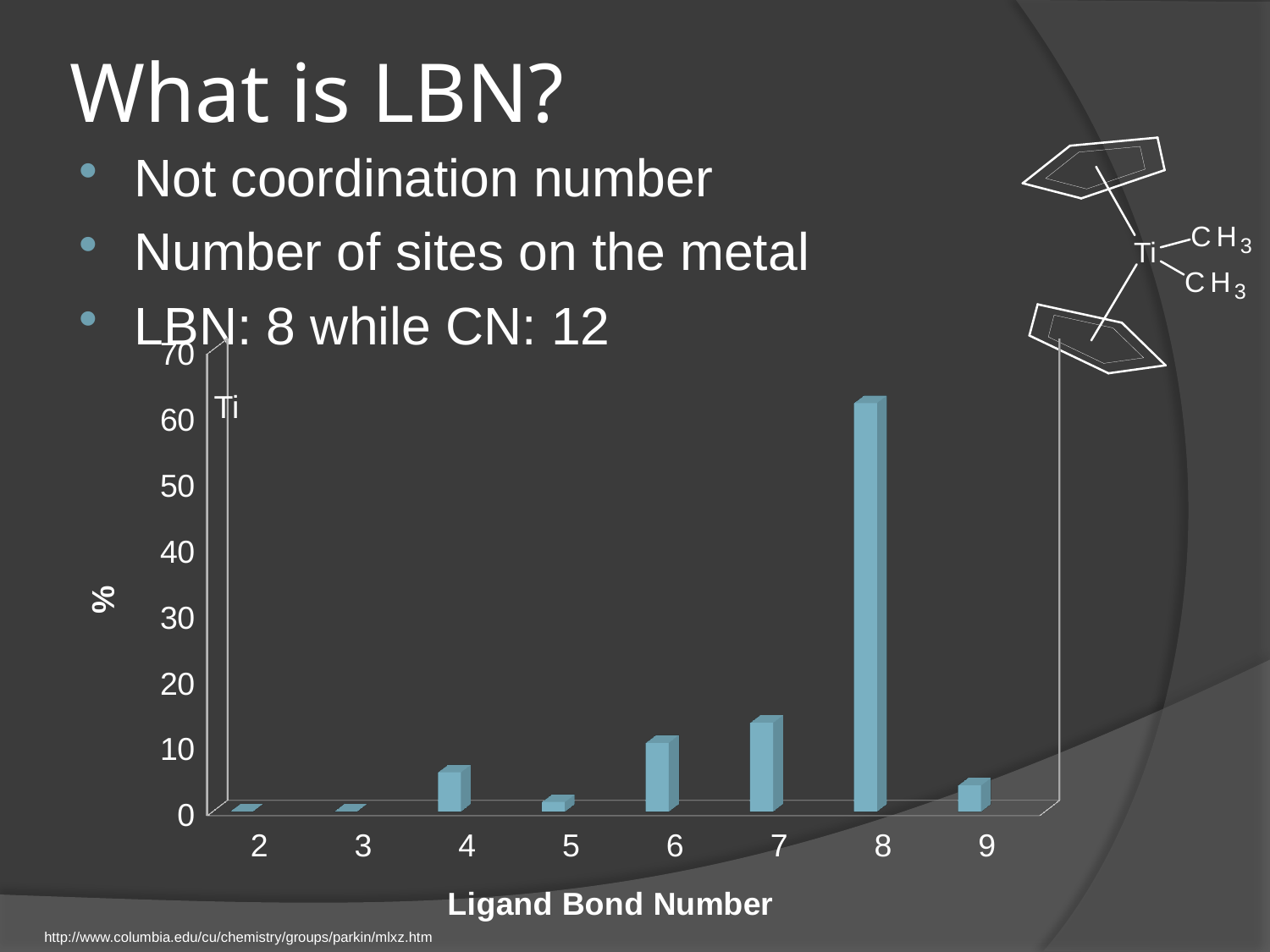
Is the value for ligand bond number 8 greater or less than 50? greater Which has a larger percentage, ligand bond number 8 or ligand bond number 7? 8 Is the value for ligand bond number 9 greater or less than 10? less Which ligand bond number has the highest percentage? 8 What kind of chart is shown on the slide? bar chart Is the value for ligand bond number 7 greater or less than 20? less How many ligand bond number categories are plotted on the x axis? 8 What is the label of the y axis of the chart? % Which has a larger percentage, ligand bond number 6 or ligand bond number 9? 6 What is the label of the x axis of the chart? Ligand Bond Number Which has a larger percentage, ligand bond number 7 or ligand bond number 4? 7